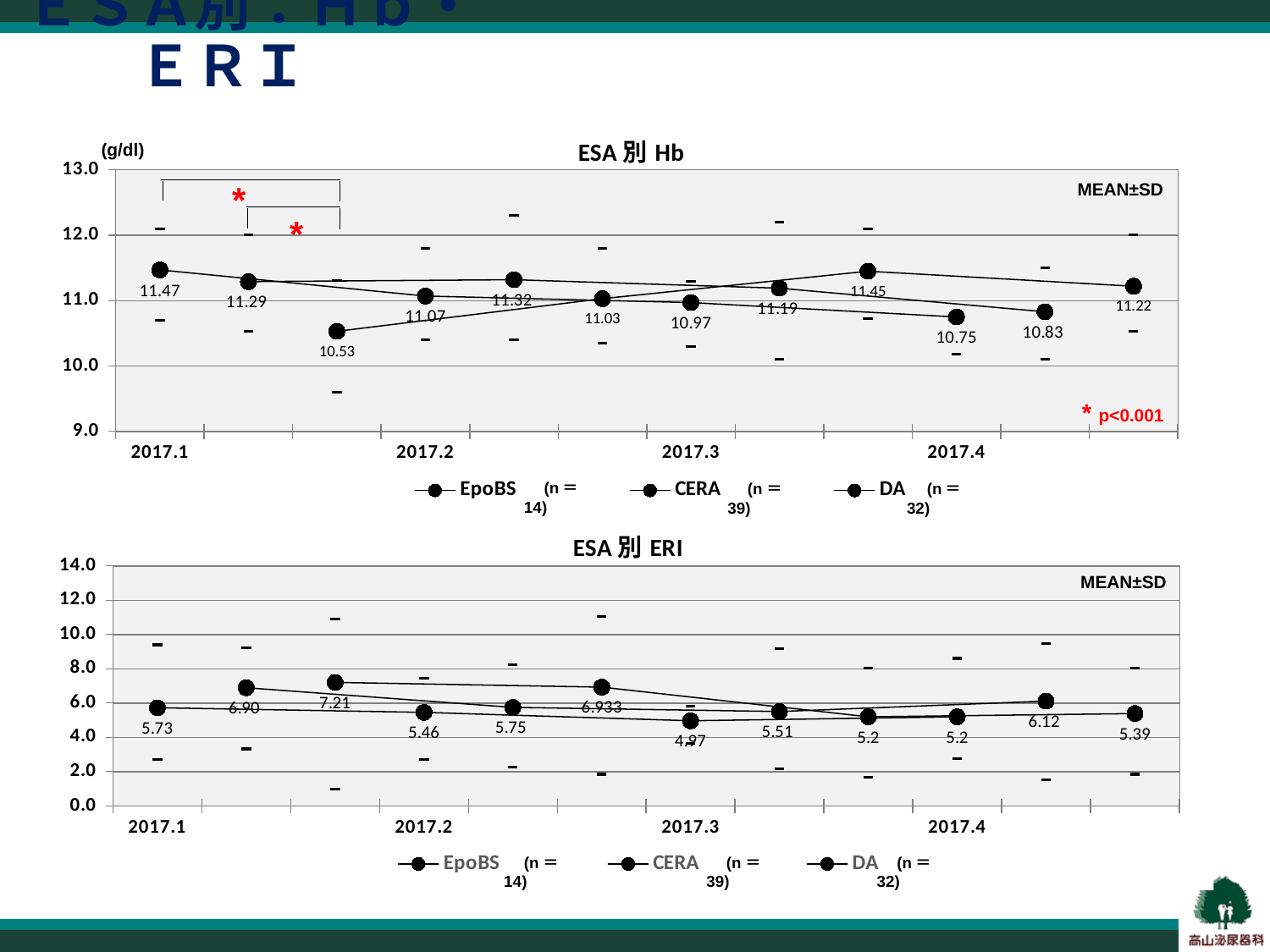
What unit is shown on the y axis of the ESA 別 Hb chart? (g/dl) In the ESA 別 Hb chart, what is the difference between the highest labeled mean (11.47) and the lowest labeled mean (10.53)? 0.94 In the ESA 別 ERI chart, what is the difference between the highest labeled mean (7.21) and the lowest labeled mean (4.97)? 2.24 In the ESA 別 Hb chart, what is the highest labeled mean value? 11.47 In the ESA 別 ERI chart, what is the highest labeled mean value? 7.21 How many series does the legend of the ESA 別 ERI chart list? 3 According to the legend of the ESA 別 Hb chart, what is the n for the CERA series? 39 In the ESA 別 ERI chart, what is the lowest labeled mean value? 4.97 In the ESA 別 Hb chart, is the highest plotted mean value greater or less than 12.0? less How many time periods are shown on the x axis of the ESA 別 Hb chart? 4 In the ESA 別 Hb chart, what is the lowest labeled mean value? 10.53 What type of chart is the ESA 別 Hb chart? line chart